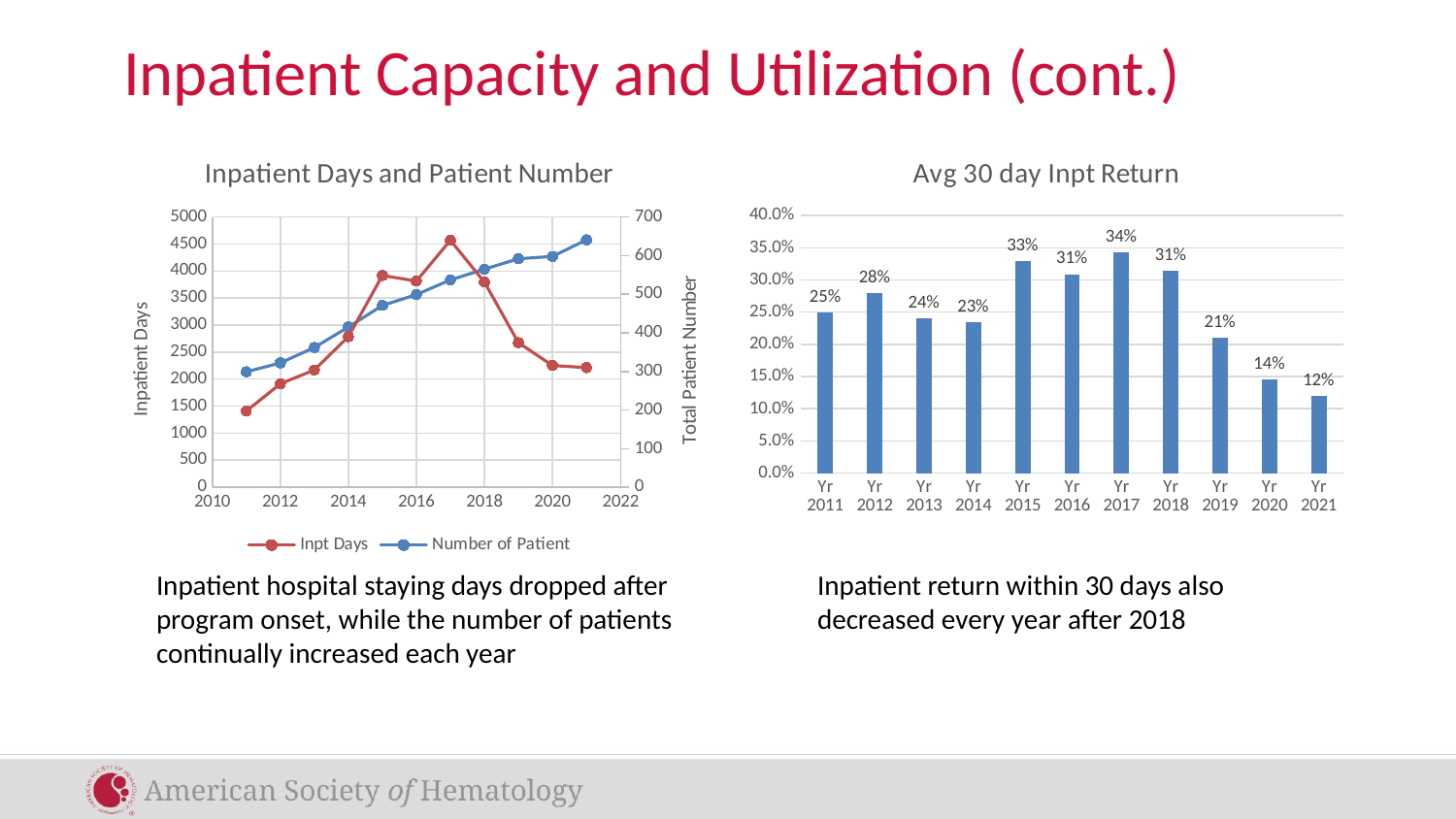
On the 'Avg 30 day Inpt Return' chart, what is the difference between the values for Yr 2018 and Yr 2019? 10% How many series does the legend of the 'Inpatient Days and Patient Number' chart list? 2 On the 'Avg 30 day Inpt Return' chart, which year has the highest value? Yr 2017 On the 'Avg 30 day Inpt Return' chart, do the values rise or fall from Yr 2018 to Yr 2021? fall On the 'Avg 30 day Inpt Return' chart, what is the value for Yr 2017? 34% On the 'Avg 30 day Inpt Return' chart, how many bars are shown? 11 What kind of chart is 'Inpatient Days and Patient Number'? line chart On the 'Avg 30 day Inpt Return' chart, which year has the lowest value? Yr 2021 On the 'Inpatient Days and Patient Number' chart, is the Inpt Days value for 2017 greater or less than 4000? greater On the 'Inpatient Days and Patient Number' chart, in which year does the Inpt Days series reach its highest value? 2017 On the 'Avg 30 day Inpt Return' chart, which is larger, the value for Yr 2012 or Yr 2014? Yr 2012 On the 'Avg 30 day Inpt Return' chart, what is the value for Yr 2021? 12%